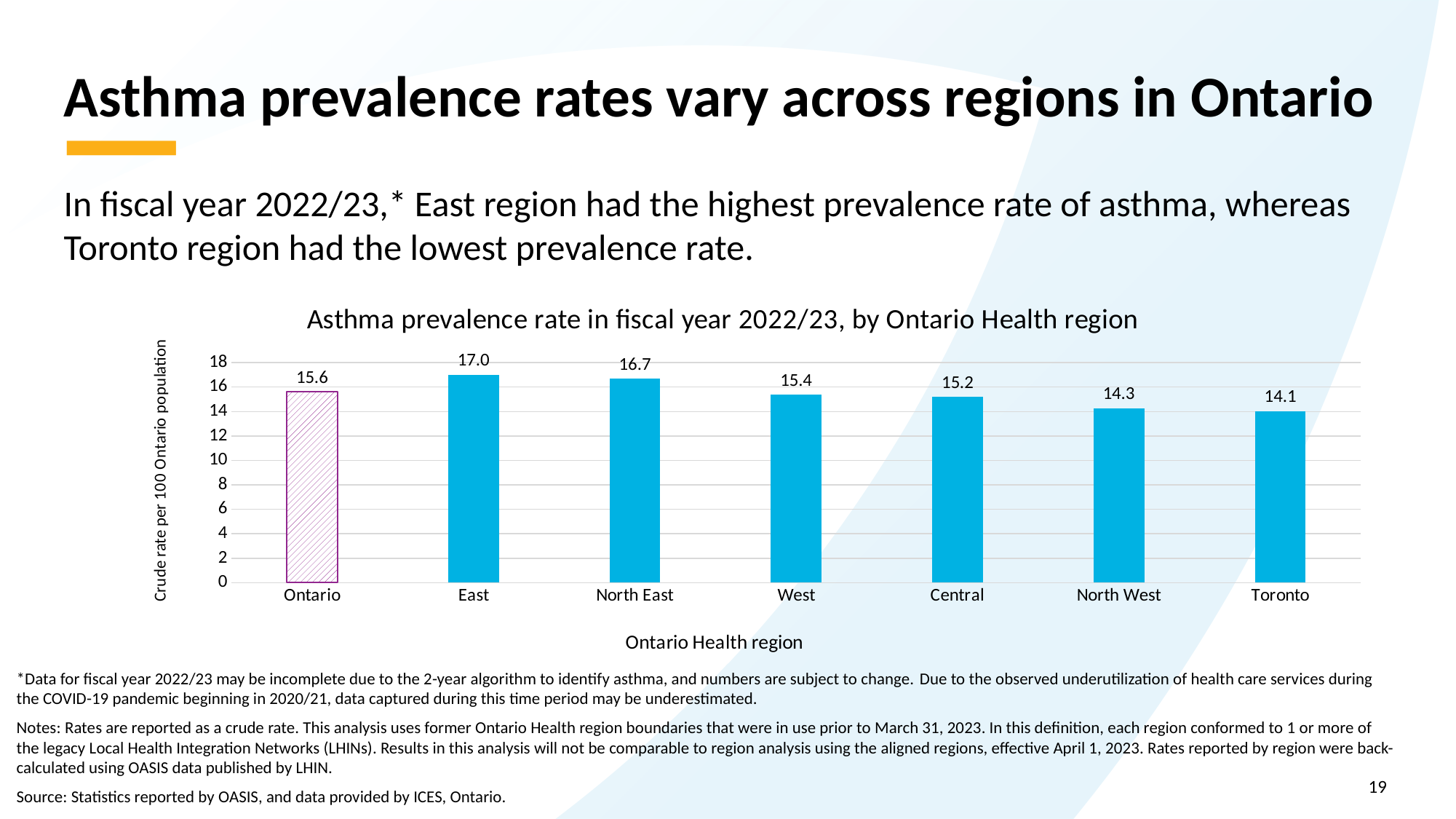
What type of chart is shown on the slide? Bar chart Which has a higher asthma prevalence rate, Central or North West? Central What is the difference between the asthma prevalence rates of East and Toronto? 2.9 What is the asthma prevalence rate for the North West region? 14.3 Which region has the lowest asthma prevalence rate? Toronto What is the difference between the asthma prevalence rates of North East and West? 1.3 What is the asthma prevalence rate for Ontario overall? 15.6 What is the asthma prevalence rate for the East region? 17.0 Which region has the highest asthma prevalence rate? East What is the label of the y axis? Crude rate per 100 Ontario population How many bars are shown in the chart? 7 Is the asthma prevalence rate for Toronto greater or less than 16? less